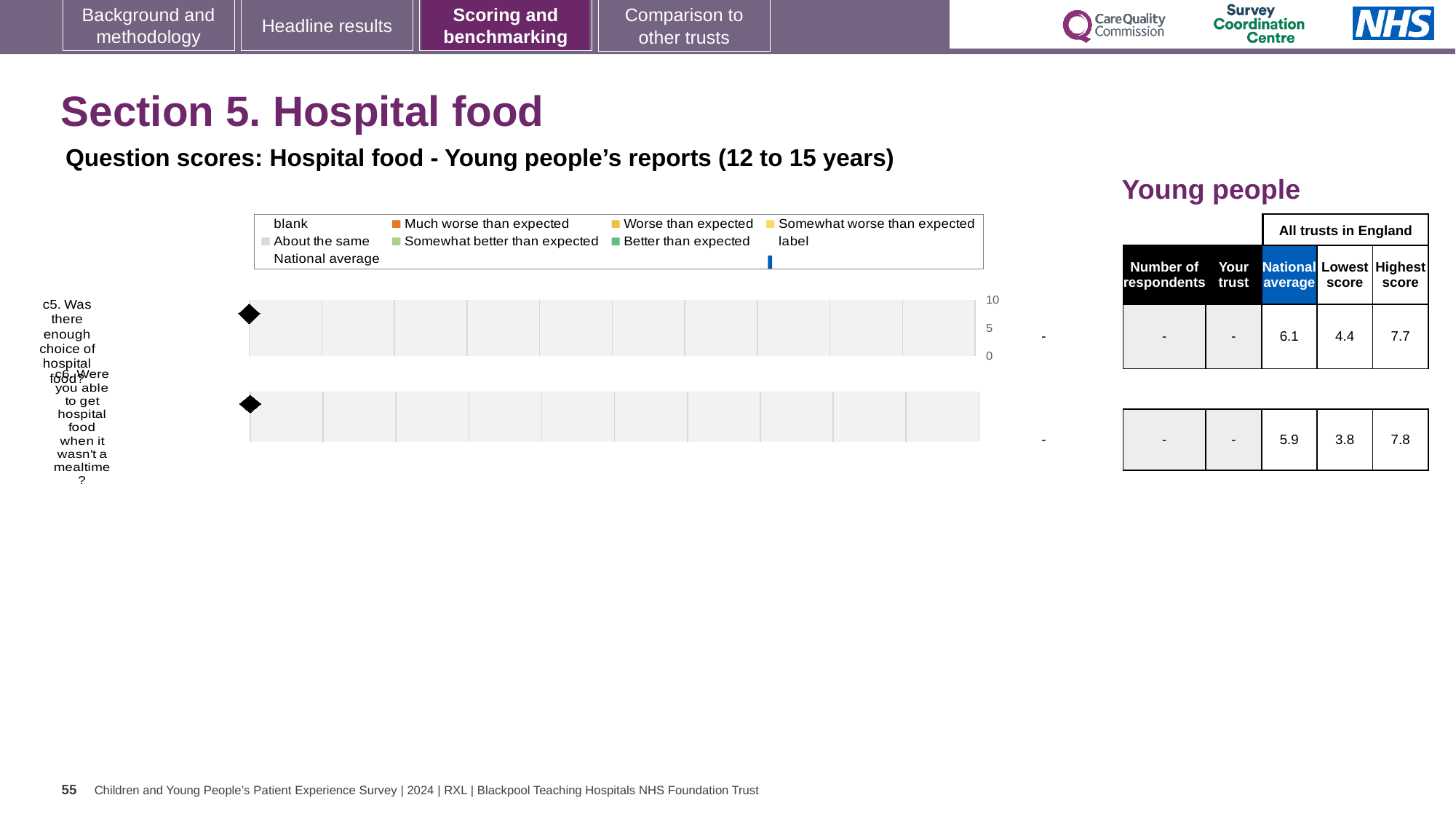
How many questions (categories) are shown on the hospital food chart? 2 What kind of chart is used to show the question scores for hospital food? Bar chart What is the lowest score across all trusts in England for c6 'Were you able to get hospital food when it wasn't a mealtime?' 3.8 Which question has the higher national average score, c5 or c6? c5 What is shown in the 'Your trust' column for c5 'Was there enough choice of hospital food?' - What is the national average score for c6 'Were you able to get hospital food when it wasn't a mealtime?' 5.9 What is the difference between the national average scores for c5 and c6? 0.2 What is the lowest score across all trusts in England for c5 'Was there enough choice of hospital food?' 4.4 What is the highest value marked on the chart's score axis? 10 What is the highest score across all trusts in England for c5 'Was there enough choice of hospital food?' 7.7 What is the highest score across all trusts in England for c6 'Were you able to get hospital food when it wasn't a mealtime?' 7.8 What is the national average score for c5 'Was there enough choice of hospital food?' 6.1